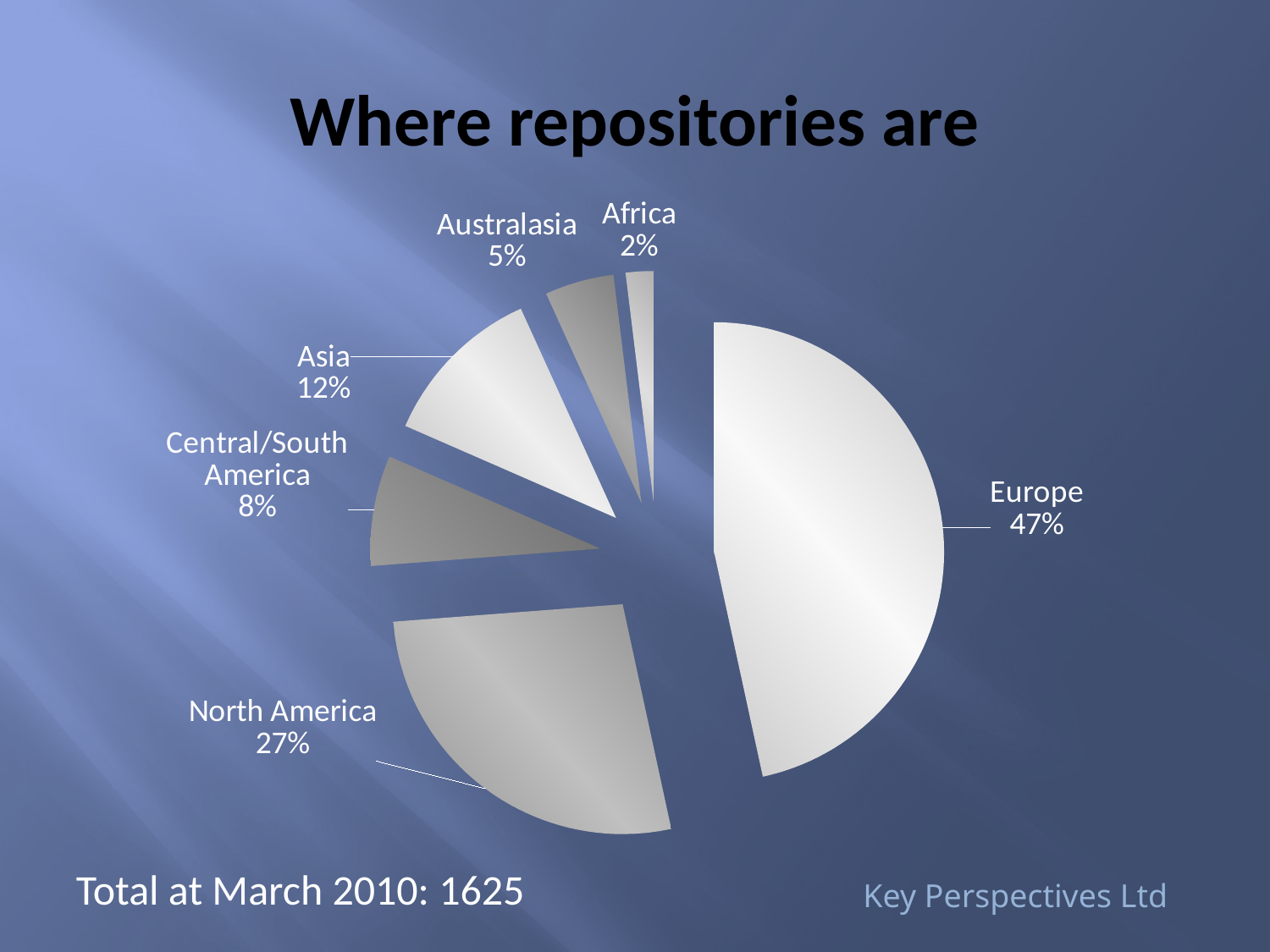
Which region has the smallest share of repositories? Africa What share of repositories is in Asia? 12% What share of repositories is in North America? 27% What share of repositories is in Africa? 2% What is the title of the chart? Where repositories are What share of repositories is in Central/South America? 8% Which has a larger share, Asia or Australasia? Asia What share of repositories is in Europe? 47% Which region has the largest share of repositories? Europe What kind of chart is shown on the slide? Pie chart How many regions are shown in the pie chart? 6 What is the difference in percentage points between Europe's share and North America's share? 20